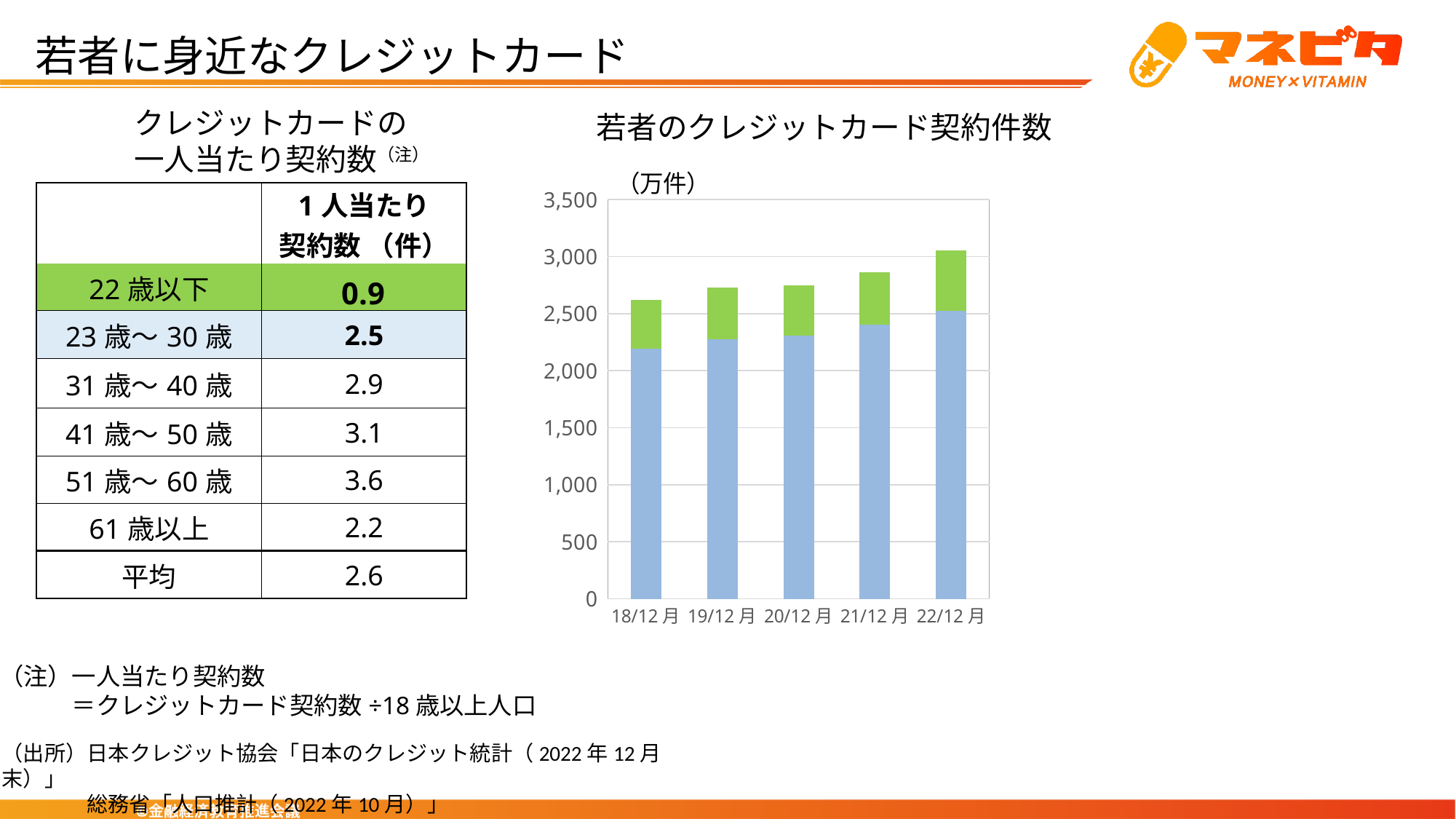
Do the total bar heights rise or fall from 18/12月 to 22/12月? rise Is the blue segment for 18/12月 greater or less than 2,000? greater Is the total bar for 21/12月 greater or less than 3,000? less Is the blue segment for 22/12月 greater or less than 3,000? less What unit is shown above the y axis of the chart? 万件 What is the title of the chart? 若者のクレジットカード契約件数 How many time periods are shown on the x axis of the chart? 5 Which period has the highest total bar in the chart? 22/12月 Which total bar is larger, 22/12月 or 18/12月? 22/12月 Which period has the lowest total bar in the chart? 18/12月 What kind of chart is shown on the slide? stacked bar chart